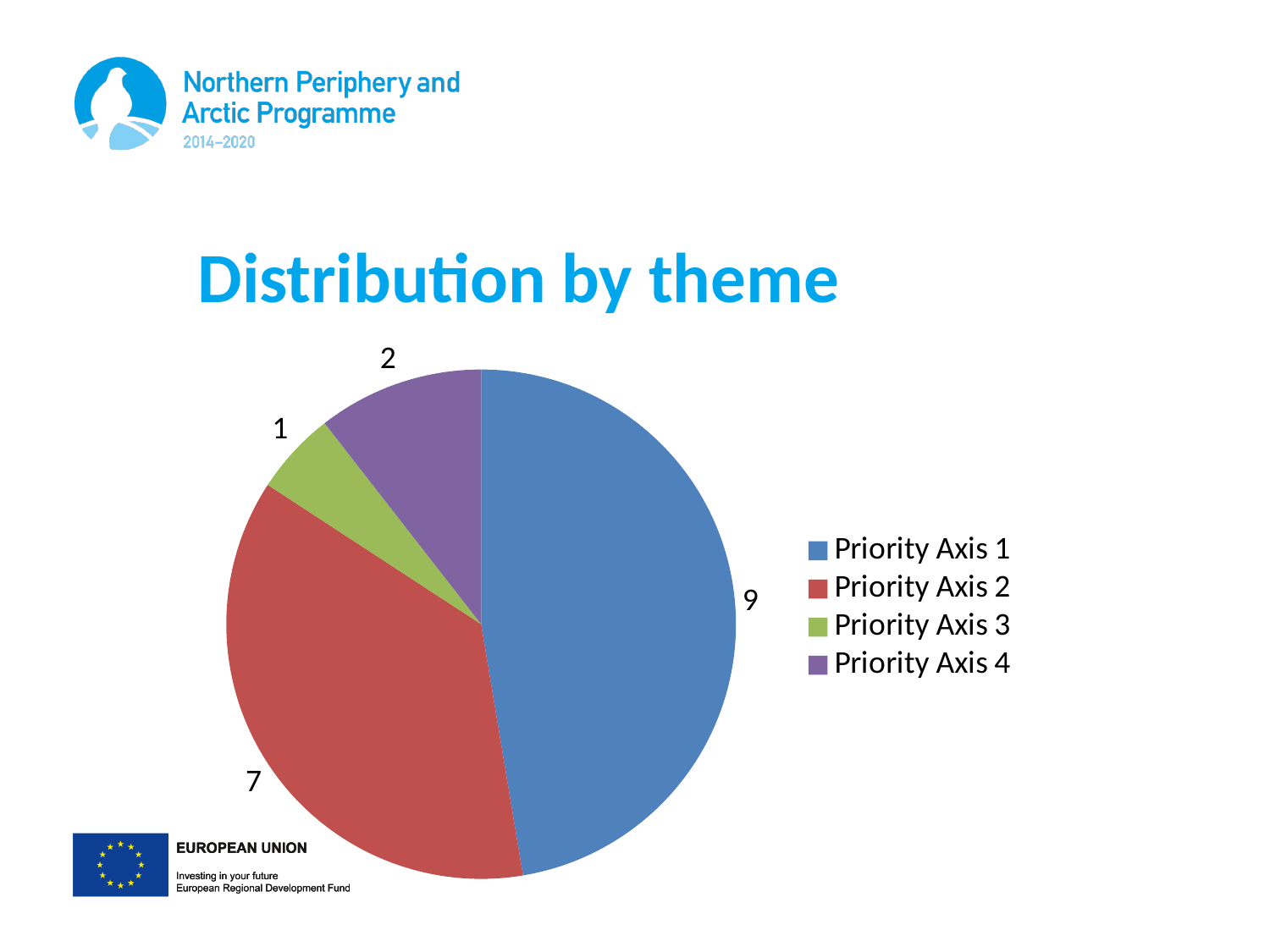
Which is larger, the value for Priority Axis 4 or the value for Priority Axis 3? Priority Axis 4 What is the value for Priority Axis 2? 7 What type of chart is shown on the slide? pie chart What is the value for Priority Axis 1? 9 What is the title of the slide containing the pie chart? Distribution by theme What is the value for Priority Axis 4? 2 How many slices does the pie chart have? 4 How many entries does the legend list? 4 What is the value for Priority Axis 3? 1 What is the difference between the values for Priority Axis 1 and Priority Axis 2? 2 Which priority axis has the smallest slice of the pie? Priority Axis 3 Which priority axis has the largest slice of the pie? Priority Axis 1